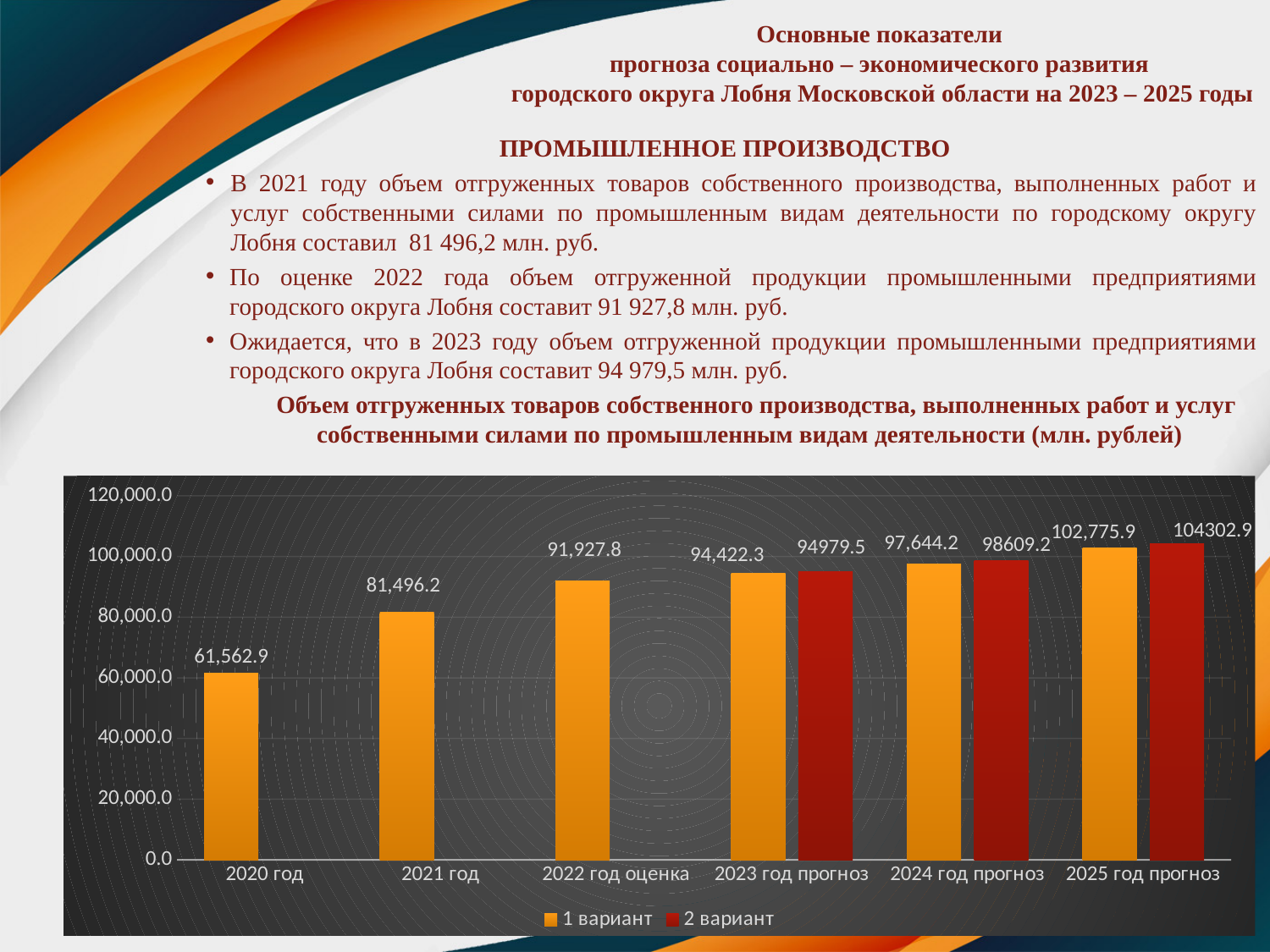
Which category has the lowest value in the chart? 2020 год What is the value for 2020 год in the chart? 61,562.9 What is the difference between the 2022 год оценка value and the 2021 год value? 10,431.6 What is the value of the 1 вариант series for 2024 год прогноз? 97,644.2 What is the value of the 2 вариант series for 2025 год прогноз? 104302.9 Which bar has the highest value in the chart? 2 вариант for 2025 год прогноз Do the 1 вариант values rise or fall from 2020 год to 2025 год прогноз? rise What is the value of the 2 вариант series for 2023 год прогноз? 94979.5 How many series does the legend list? 2 What is the difference between the values for 2021 год and 2020 год? 19,933.3 What is the value of the 1 вариант series for 2021 год? 81,496.2 For 2024 год прогноз, which series has the larger value, 1 вариант or 2 вариант? 2 вариант